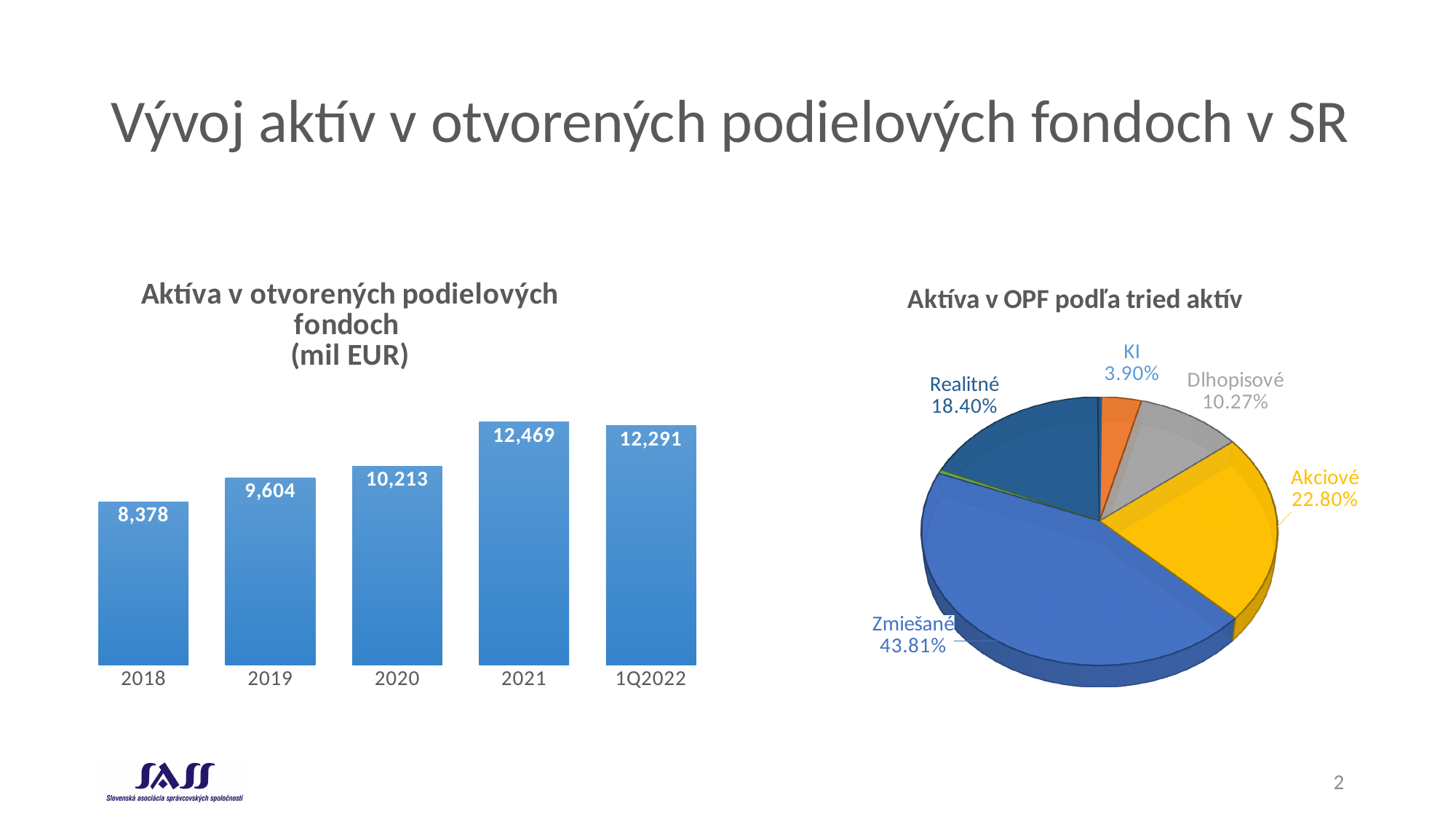
In the pie chart on the right, what is the difference between the shares of Realitné and Dlhopisové? 8.13% How many bars are shown in the bar chart on the left? 5 In the bar chart on the left, do the values rise or fall from 2018 to 2021? rise In the bar chart on the left, is the value for 2019 larger or smaller than the value for 2020? smaller In the bar chart on the left, what is the value for 1Q2022? 12,291 In the pie chart on the right, what share does Akciové have? 22.80% In the bar chart on the left, which category has the lowest value? 2018 In the pie chart on the right, which labelled slice is the largest? Zmiešané In the bar chart on the left, what is the value for 2020? 10,213 In the bar chart on the left, what is the difference between the values for 2021 and 1Q2022? 178 In the bar chart on the left, which year has the highest value? 2021 What kind of chart is the chart on the right, titled 'Aktíva v OPF podľa tried aktív'? pie chart